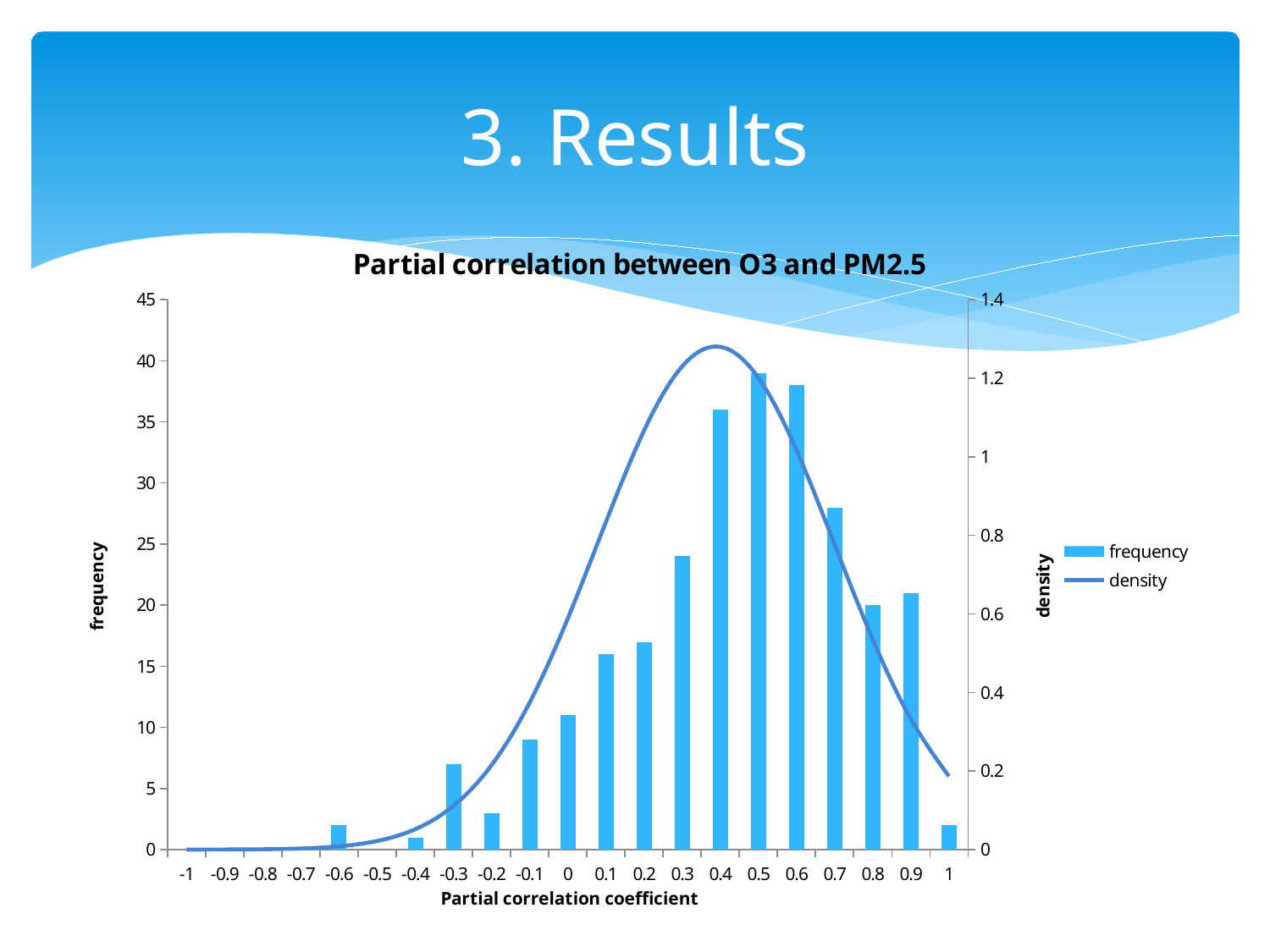
What is the label of the right-hand vertical axis? density Is the frequency value for 0.2 greater or less than 20? less Is the frequency value for 0.7 greater or less than 25? greater Is the frequency value for -0.3 greater or less than 5? greater What kind of chart is used to show the frequency series? bar chart What is the title of the chart? Partial correlation between O3 and PM2.5 Which has the higher frequency, 0 or 0.1? 0.1 Which has the higher frequency, 0.4 or 0.7? 0.4 How many series does the legend list? 2 Do the frequency bars rise or fall as the partial correlation coefficient goes from 0 to 0.5? rise